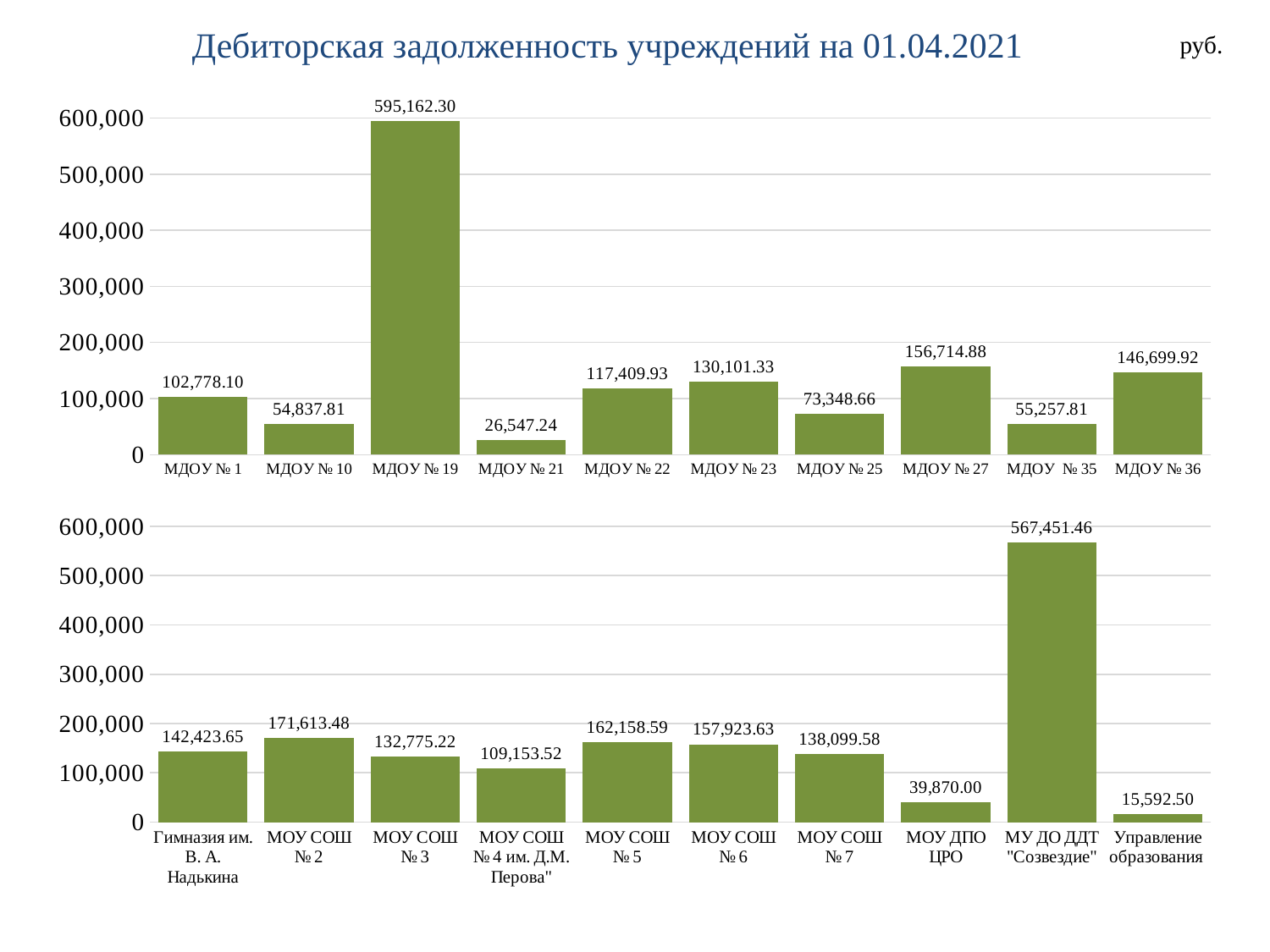
In the top chart, what is the value for МДОУ № 19? 595,162.30 In the bottom chart, what is the value for Гимназия им. В. А. Надькина? 142,423.65 In the top chart, which category has the lowest value? МДОУ № 21 In the bottom chart, which category has the lowest value? Управление образования In the bottom chart, what is the value for МОУ ДПО ЦРО? 39,870.00 In the bottom chart, what is the difference between the values for МОУ СОШ № 2 and МОУ СОШ № 5? 9,454.89 In the top chart, what is the difference between the values for МДОУ № 27 and МДОУ № 36? 10,014.96 What kind of chart is the top chart? Bar chart In the top chart, what is the value for МДОУ № 25? 73,348.66 In the bottom chart, which category has the highest value? МУ ДО ДДТ "Созвездие" How many categories are shown in the bottom chart? 10 In the top chart, which is larger: the value for МДОУ № 22 or МДОУ № 23? МДОУ № 23